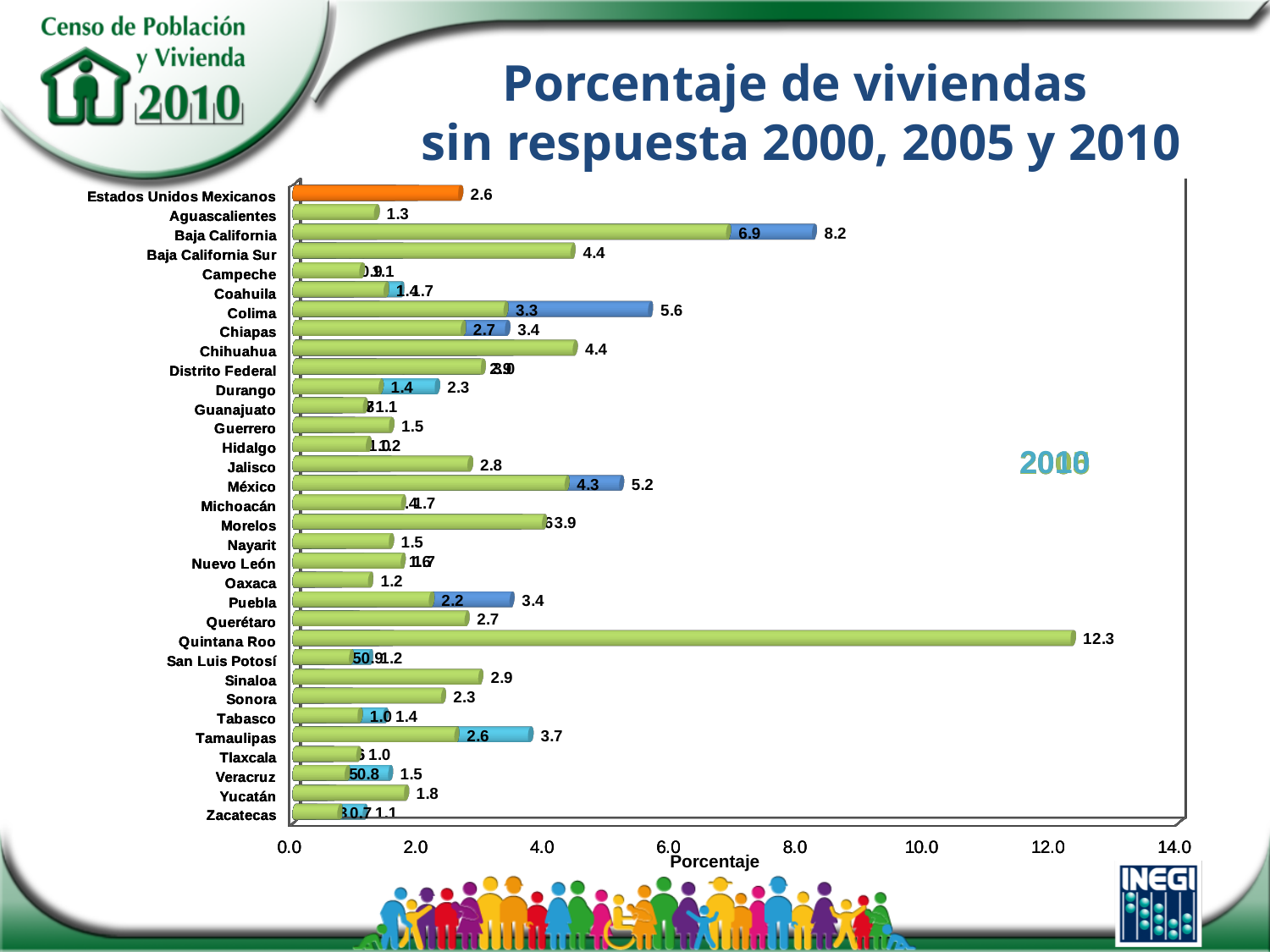
What value is labelled for Querétaro? 2.7 What value is labelled for Aguascalientes? 1.3 Which is larger, the value for Chihuahua or the value for Jalisco? Chihuahua How many categories are listed on the vertical axis of the chart? 33 What value is labelled for Estados Unidos Mexicanos? 2.6 What is the difference between the value for Quintana Roo (12.3) and the value for Baja California Sur (4.4)? 7.9 What kind of chart is shown on the slide? bar chart What is the title of the horizontal axis? Porcentaje What value is labelled for Quintana Roo? 12.3 Which category has the longest bar in the chart? Quintana Roo What value is labelled for Baja California Sur? 4.4 Is the value for Quintana Roo greater or less than 10.0? greater